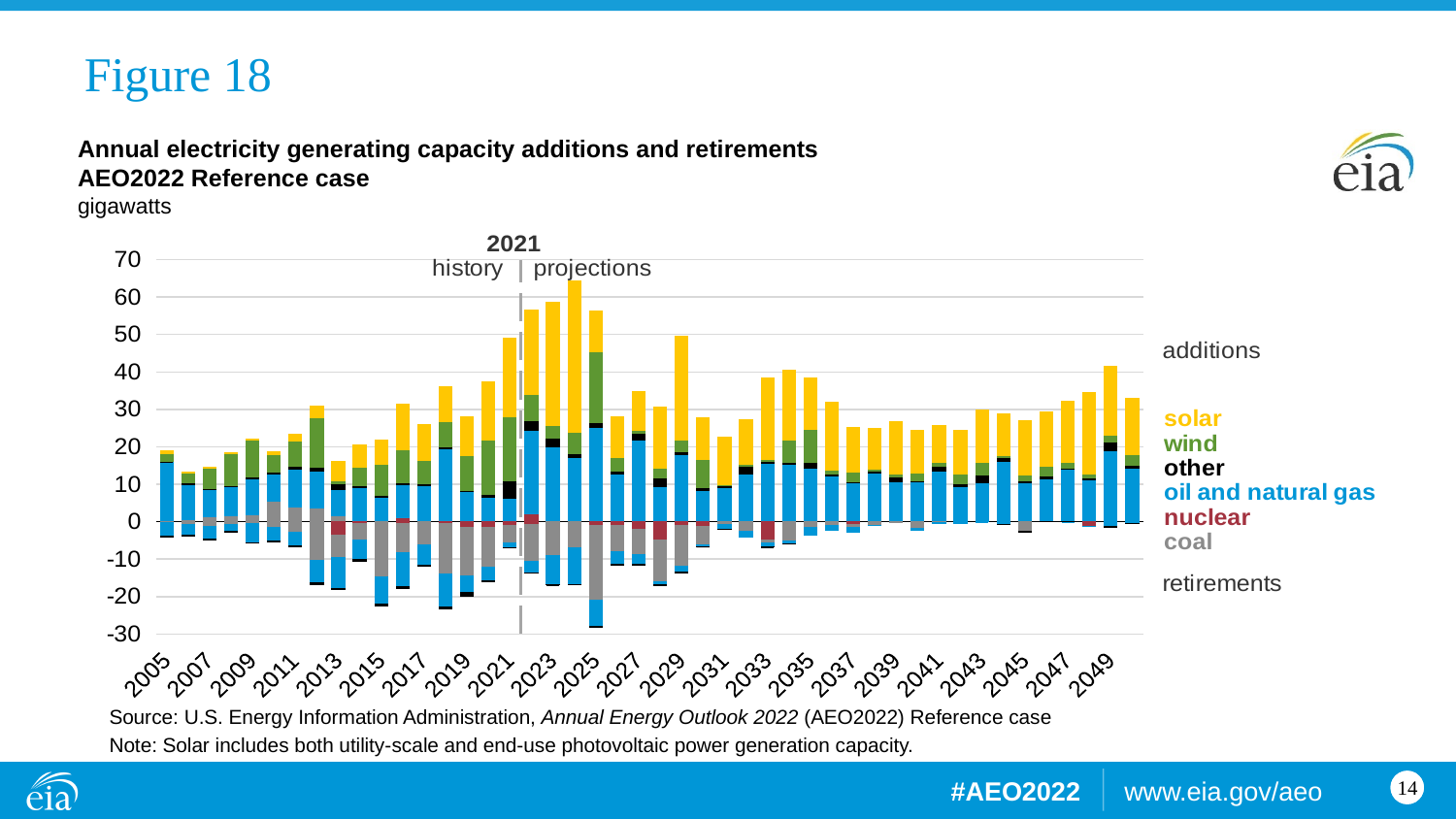
Is the total additions value for 2037 greater or less than 30? less Is the total additions value for 2022 greater or less than 50? greater What unit is the y axis measured in? gigawatts Do capacity retirements get larger or smaller in magnitude from 2030 to 2049? smaller What type of chart is shown on the slide? stacked bar chart Which year does the dashed vertical line separating history from projections mark? 2021 Which year has the highest total capacity additions? 2024 How many series does the legend list? 6 Which year has larger total additions, 2022 or 2040? 2022 Is the total additions value for 2012 greater or less than 20? greater Which year has the largest capacity retirements (most negative bar)? 2025